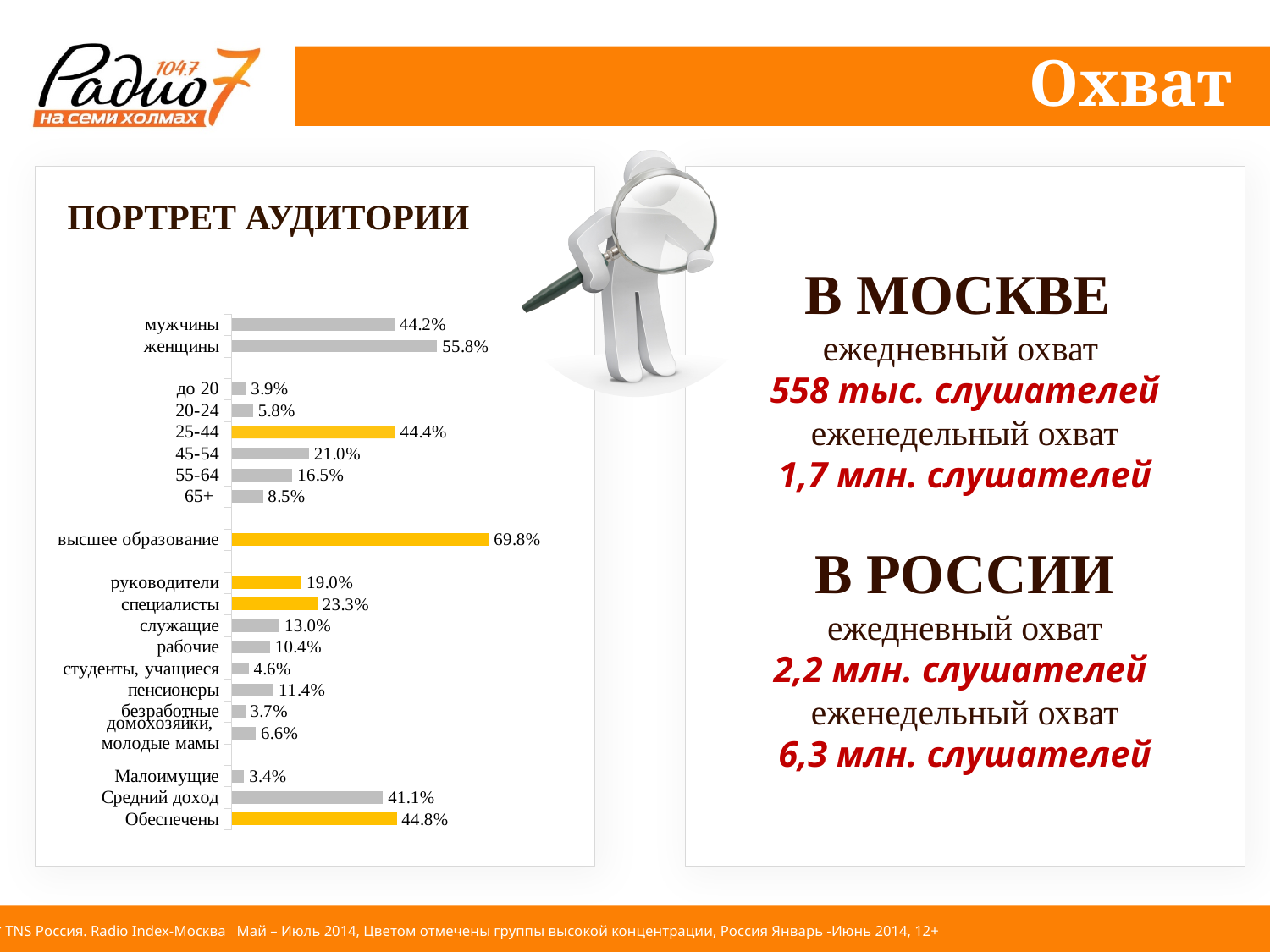
What is the value for женщины? 55.8% What type of chart is shown on the slide? bar chart Which category has the lowest value in the chart? Малоимущие What is the value for Средний доход? 41.1% What is the difference between the values for женщины and мужчины? 11.6% What is the value for специалисты? 23.3% Which is larger, the value for руководители or the value for служащие? руководители How many categories are plotted in the chart? 20 Which category has the highest value in the chart? высшее образование What is the difference between the values for 45-54 and 55-64? 4.5% What is the title of the chart? ПОРТРЕТ АУДИТОРИИ What is the value for the 25-44 age group? 44.4%